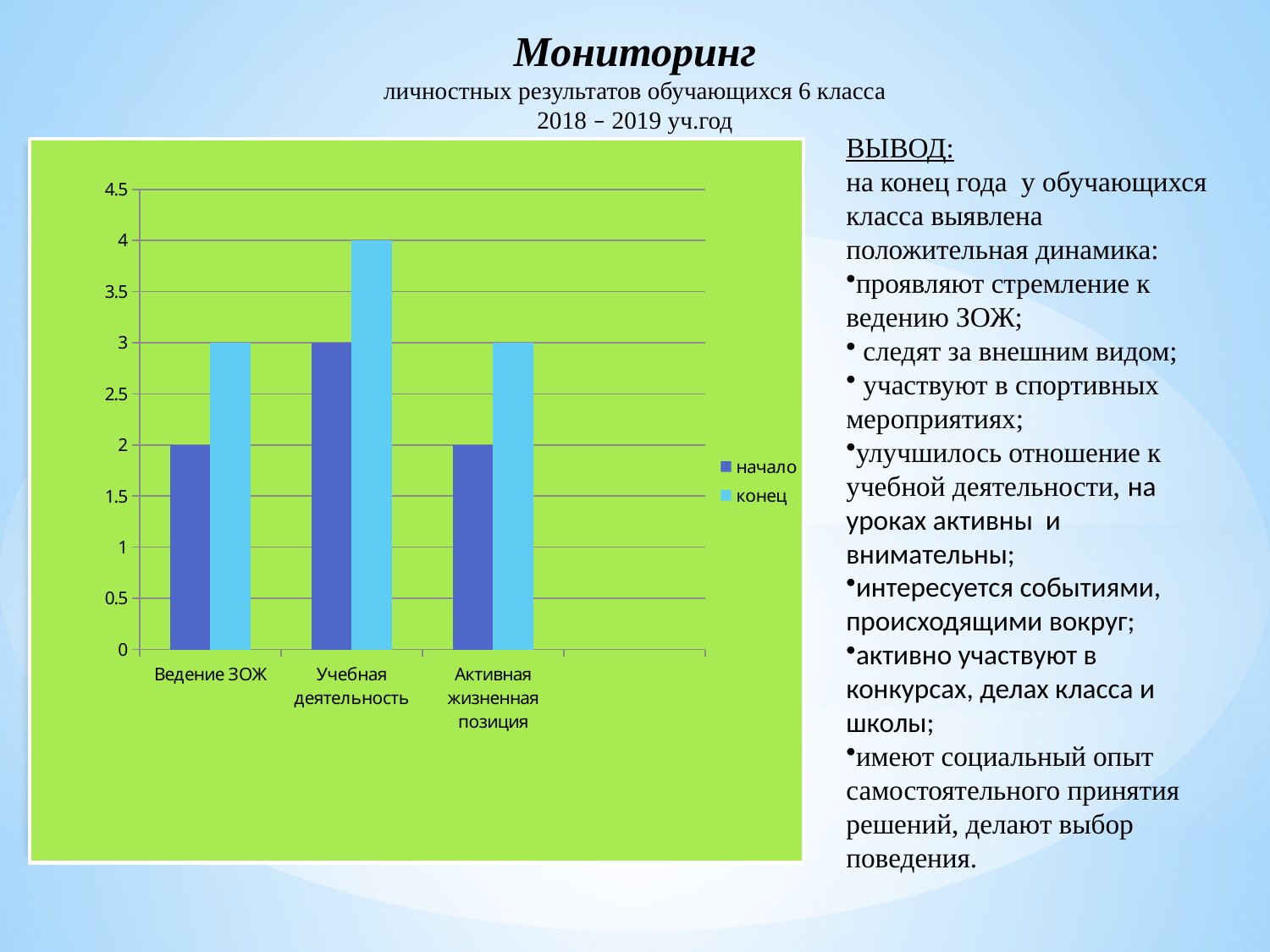
What is the highest value shown on the chart's vertical axis? 4.5 How many categories are shown on the x axis of the chart? 3 For 'Ведение ЗОЖ', which is larger: the 'начало' value or the 'конец' value? конец Which category has the highest value in the 'конец' series? Учебная деятельность What is the value of the 'начало' series for 'Ведение ЗОЖ'? 2 What is the value of the 'конец' series for 'Активная жизненная позиция'? 3 What is the difference between the 'конец' and 'начало' values for 'Учебная деятельность'? 1 Is the 'конец' value for 'Учебная деятельность' greater or less than 3.5? greater What kind of chart is shown on the slide? bar chart How many series does the chart's legend list? 2 What are the two series named in the legend? начало, конец What is the value of the 'конец' series for 'Учебная деятельность'? 4